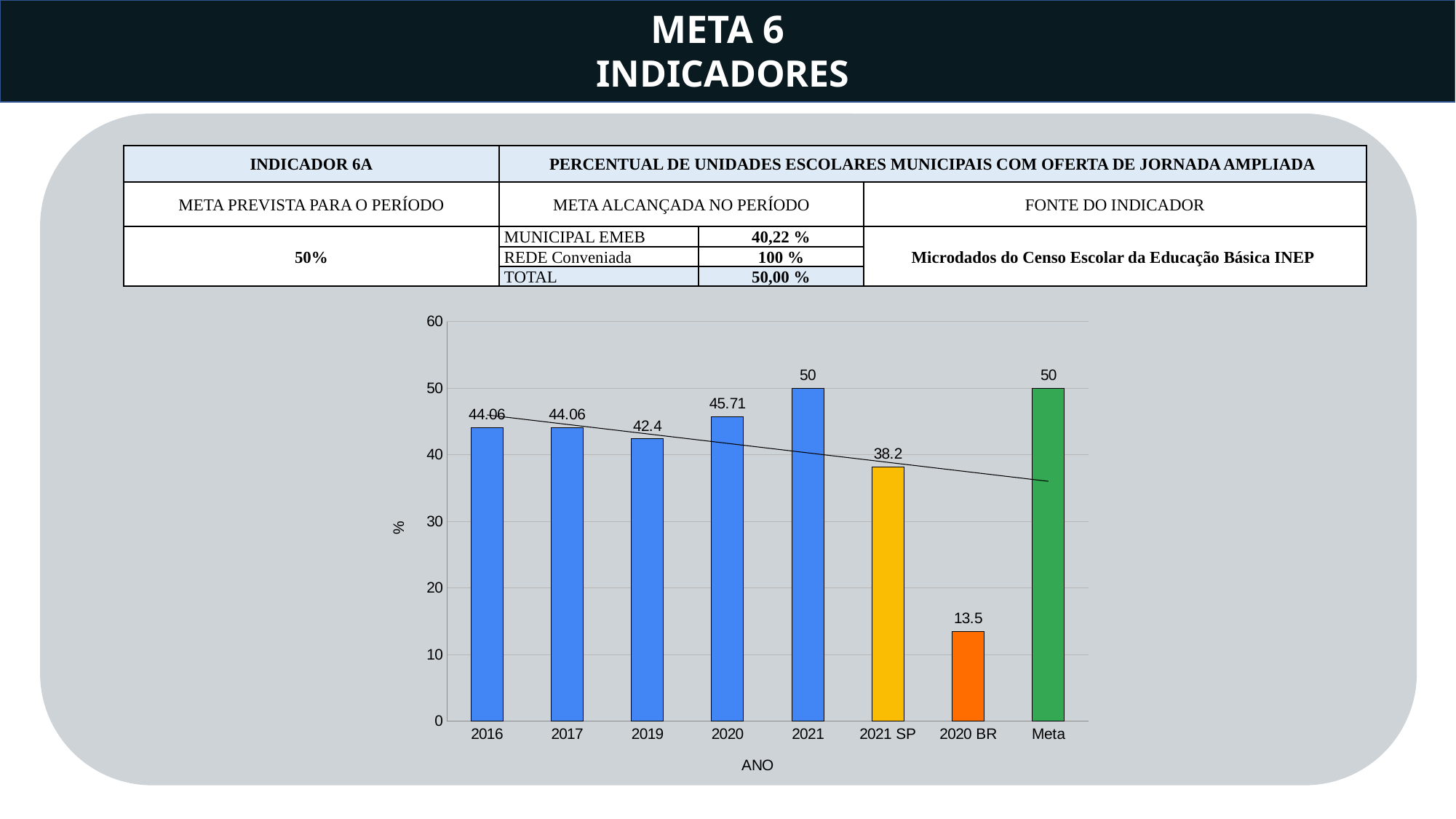
What is the difference between the Meta value and the 2021 SP value in the bar chart? 11.8 How many bars are shown in the bar chart? 8 What is the difference between the values for 2020 and 2019 in the bar chart? 3.31 What is the value for 2019 in the bar chart? 42.4 Which is larger in the bar chart, the value for 2020 or the value for 2021 SP? 2020 Which category has the lowest value in the bar chart? 2020 BR Is the value for 2020 BR greater or less than 20 in the bar chart? less What is the value for 2020 in the bar chart? 45.71 What kind of chart is shown on the slide? bar chart What is the value for 2020 BR in the bar chart? 13.5 What is the value for 2021 SP in the bar chart? 38.2 What is the label of the x axis of the bar chart? ANO